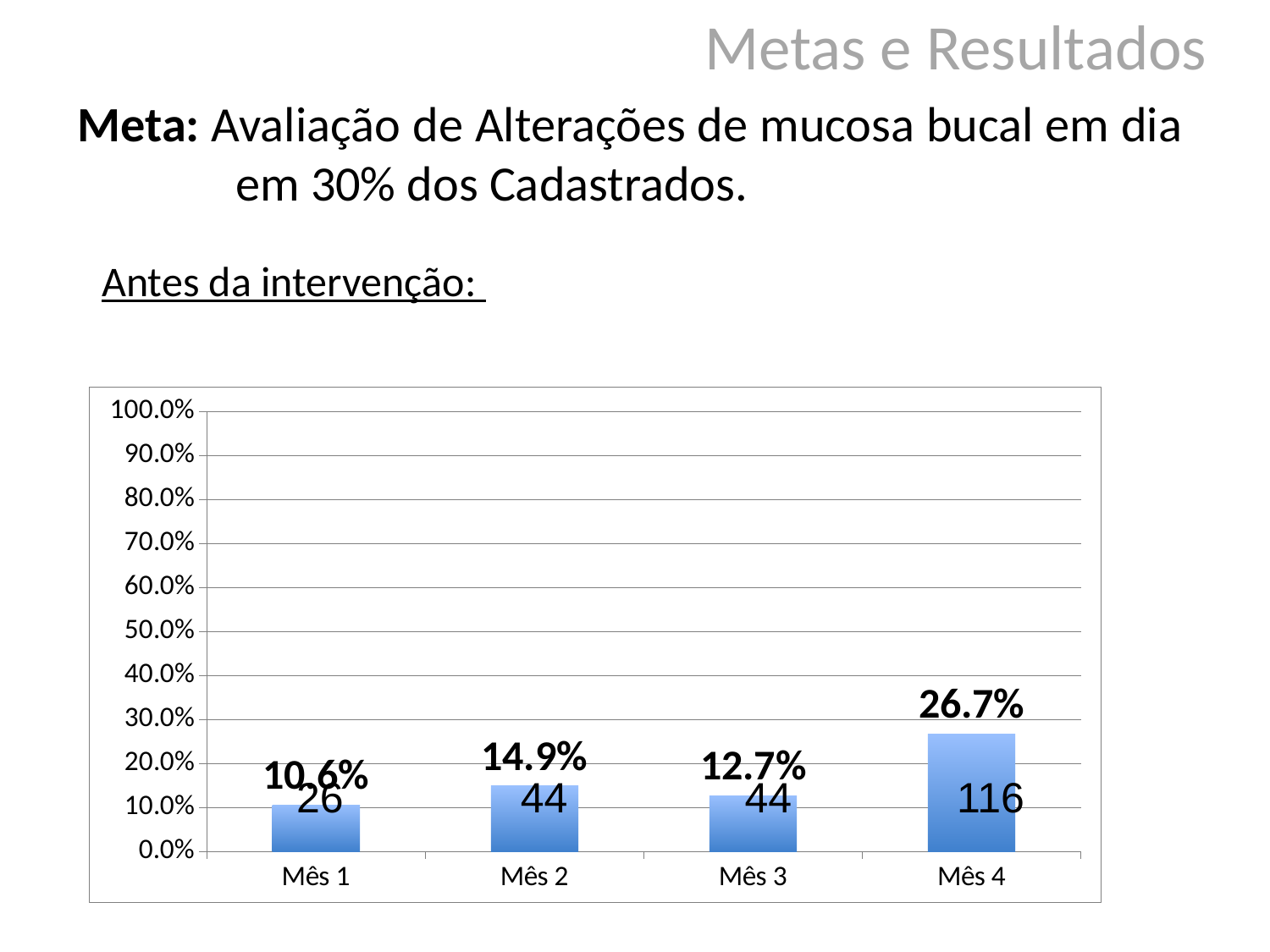
What count is printed inside the bar for Mês 4? 116 What percentage is shown for Mês 1? 10.6% How many months are shown on the x axis? 4 What count is printed inside the bar for Mês 2? 44 What kind of chart is shown on the slide? bar chart What is the difference in percentage points between Mês 4 and Mês 1? 16.1 Which has a higher percentage, Mês 2 or Mês 3? Mês 2 What percentage is shown for Mês 4? 26.7% Which month has the lowest percentage? Mês 1 What is the maximum value shown on the y axis? 100.0% Which month has the highest percentage? Mês 4 Is the value for Mês 4 greater or less than 30.0%? less